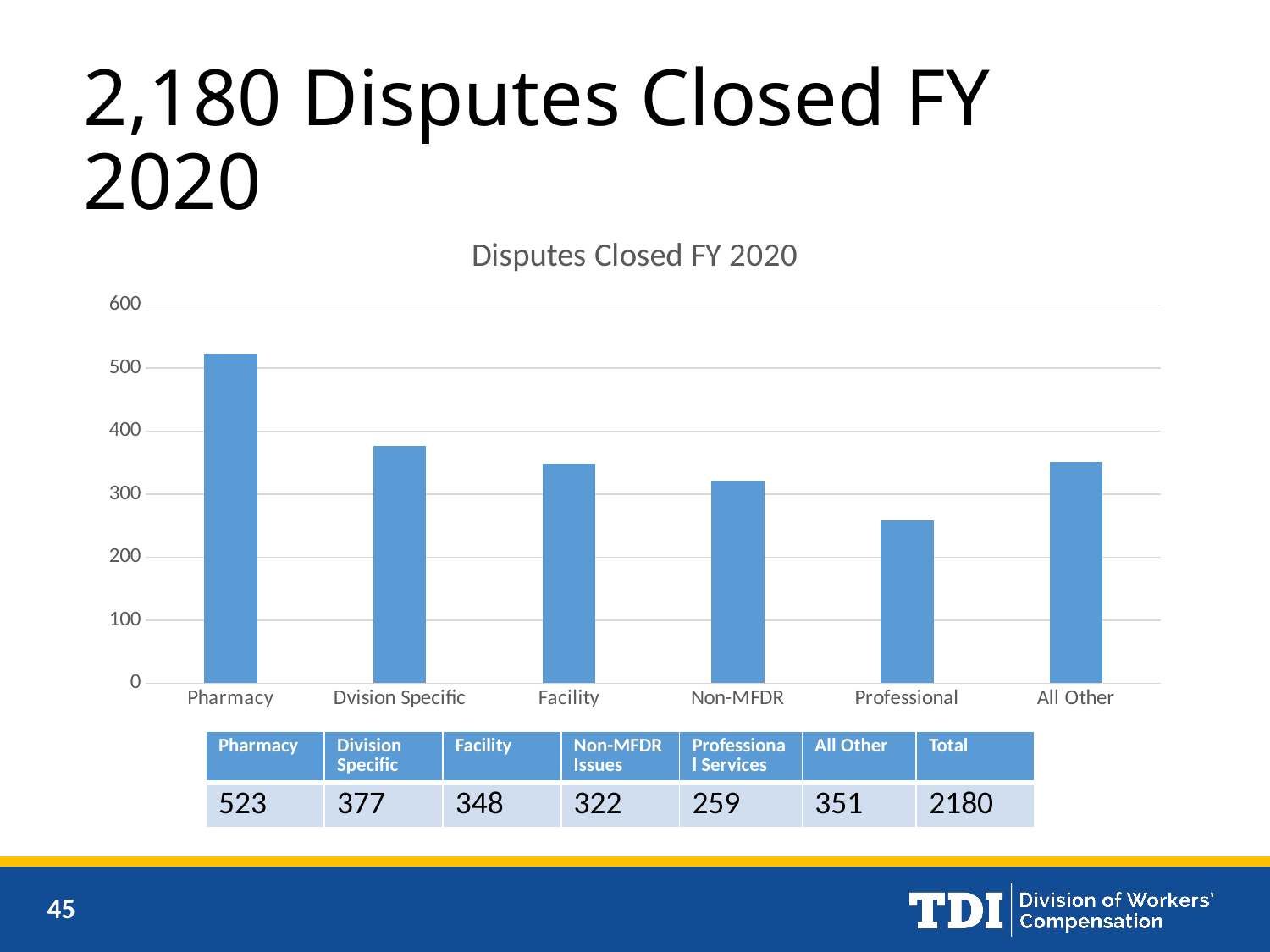
Which category has the highest value in the Disputes Closed FY 2020 chart? Pharmacy What is the title of the chart on the slide? Disputes Closed FY 2020 What is the difference between the Pharmacy and Professional values in the Disputes Closed FY 2020 chart? 264 What is the value for Professional in the Disputes Closed FY 2020 chart? 259 Which is larger in the Disputes Closed FY 2020 chart, Dvision Specific or Non-MFDR? Dvision Specific How many categories are shown on the x axis of the Disputes Closed FY 2020 chart? 6 What is the total of all categories shown in the table below the Disputes Closed FY 2020 chart? 2180 Is the value for Facility in the Disputes Closed FY 2020 chart greater or less than 400? less What is the value for Pharmacy in the Disputes Closed FY 2020 chart? 523 What is the value for Non-MFDR in the Disputes Closed FY 2020 chart? 322 Which category has the lowest value in the Disputes Closed FY 2020 chart? Professional What kind of chart is the Disputes Closed FY 2020 chart? bar chart